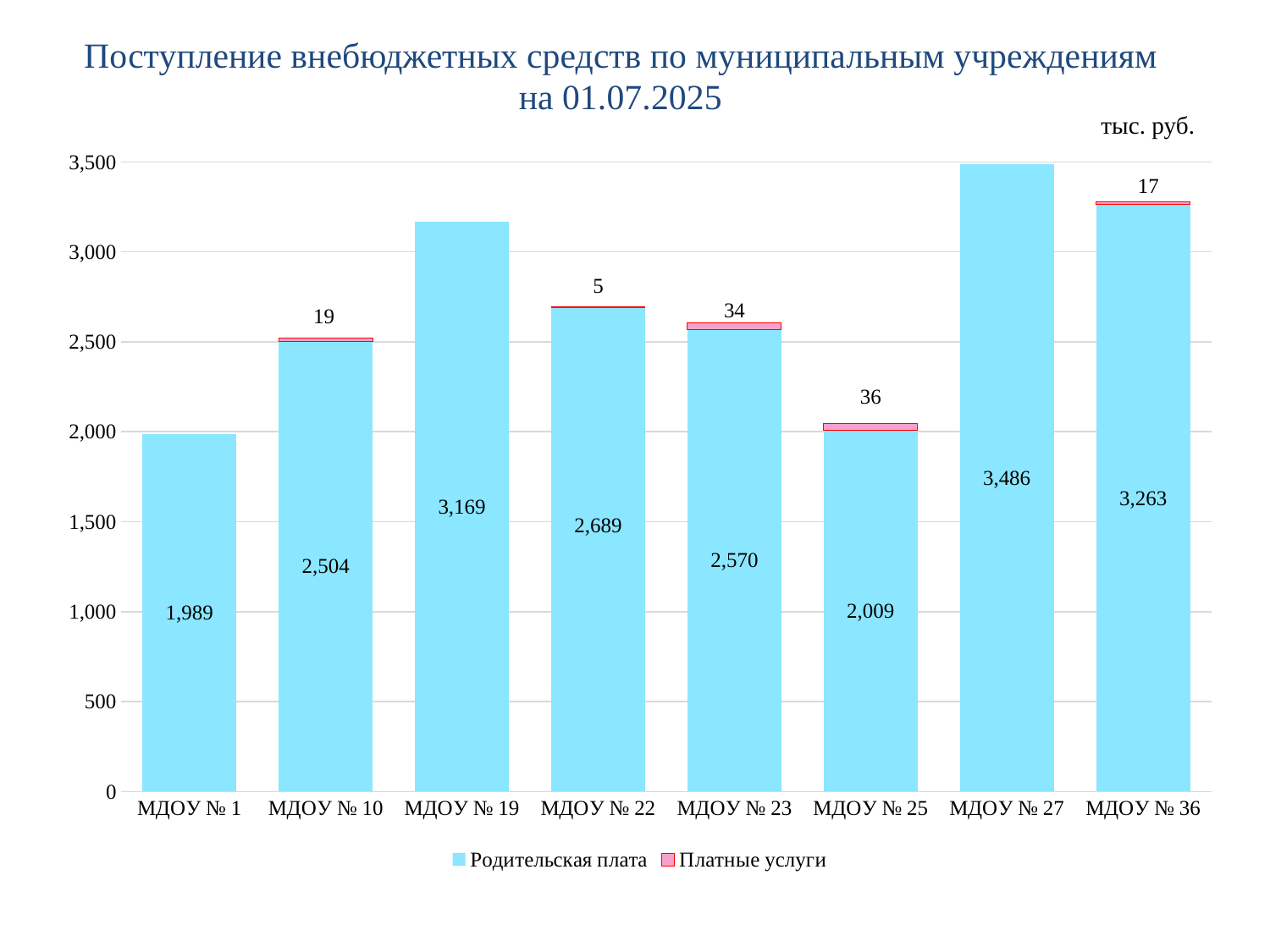
What is the Платные услуги value for МДОУ № 25? 36 How many series does the legend list? 2 What kind of chart is shown on the slide? stacked bar chart How many institutions are shown on the x axis? 8 What unit is indicated above the chart? тыс. руб. What is the total of the stacked bar for МДОУ № 23? 2,604 Is the Родительская плата value for МДОУ № 22 greater or less than 2,500? greater Which institution has the highest Родительская плата value? МДОУ № 27 Which institution has the lowest Родительская плата value? МДОУ № 1 Which is larger, the Платные услуги value for МДОУ № 10 or for МДОУ № 36? МДОУ № 10 What is the Родительская плата value for МДОУ № 19? 3,169 What is the difference between the Родительская плата values for МДОУ № 27 and МДОУ № 1? 1,497